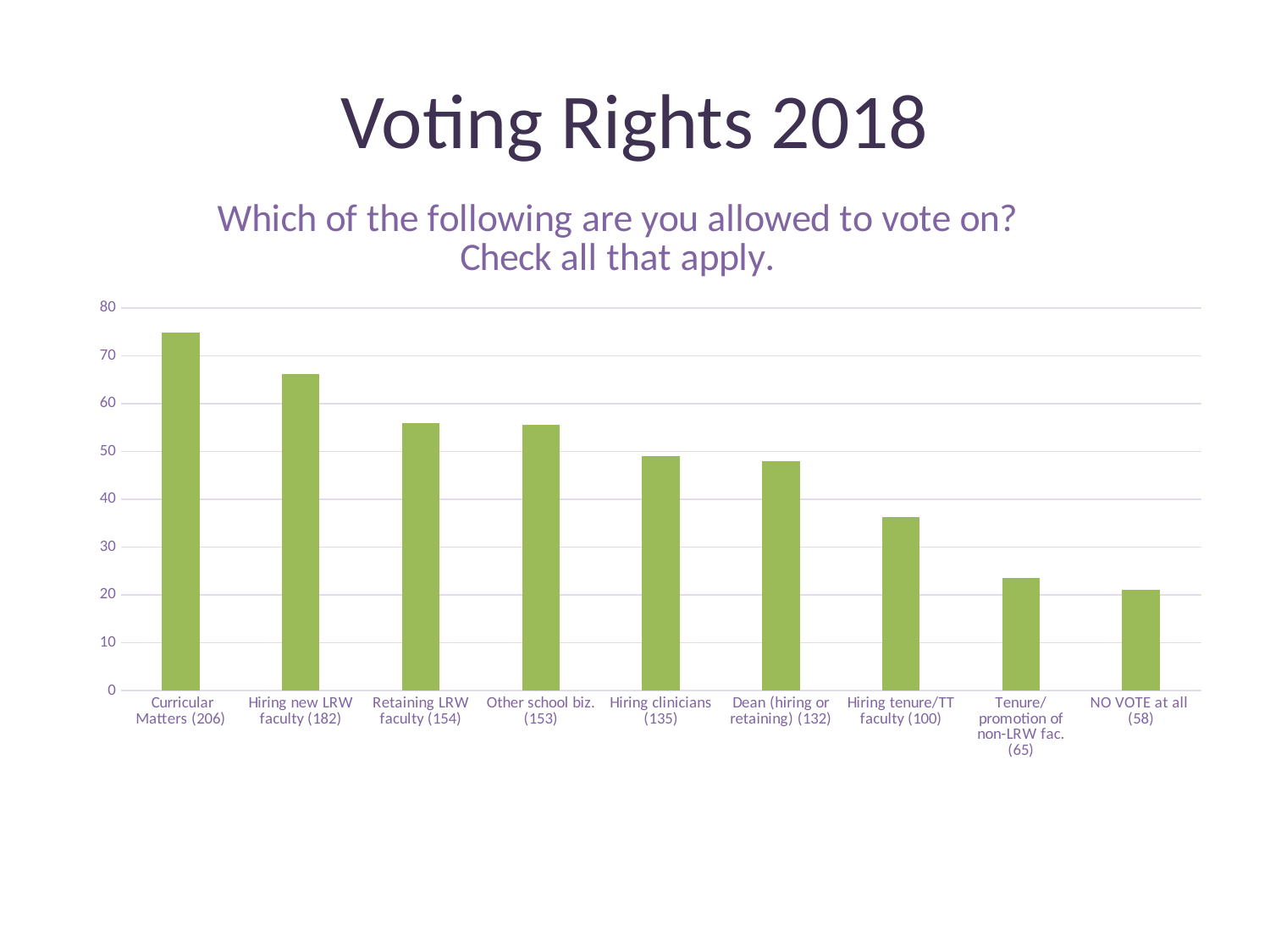
Is the value for Curricular Matters (206) greater or less than 70? greater Is the value for NO VOTE at all (58) greater or less than 30? less Which is larger, the value for Hiring new LRW faculty (182) or the value for Hiring tenure/TT faculty (100)? Hiring new LRW faculty (182) How many categories are shown on the x axis of the chart? 9 Is the value for Hiring new LRW faculty (182) greater or less than 60? greater Which category has the lowest bar? NO VOTE at all (58) What type of chart is shown on the slide? bar chart What is the title of the chart? Which of the following are you allowed to vote on? Check all that apply. Do the bar values rise or fall from left to right across the x axis? fall Which category has the highest bar? Curricular Matters (206)